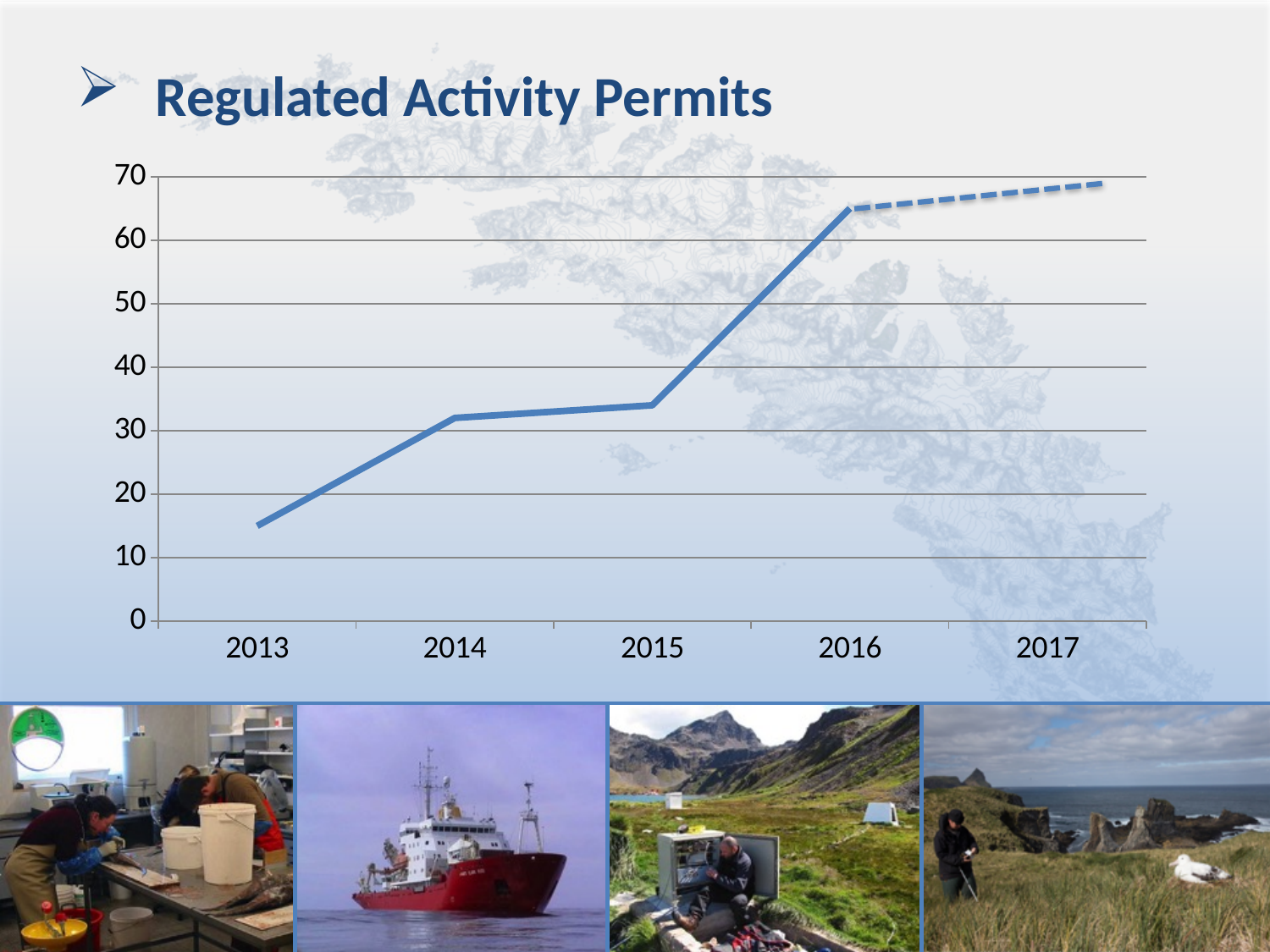
Do the values rise or fall from 2013 to 2017? rise Is the value for 2013 greater or less than 20? less Between which two years is the line drawn as a dashed segment? 2016 and 2017 Is the value for 2016 greater or less than 60? greater Which is larger, the value for 2013 or the value for 2016? 2016 How many years are shown on the x axis of the chart? 5 What is the title of the chart? Regulated Activity Permits Is the value for 2014 greater or less than 30? greater Which year has the lowest value on the chart? 2013 What kind of chart is shown on the slide? line chart